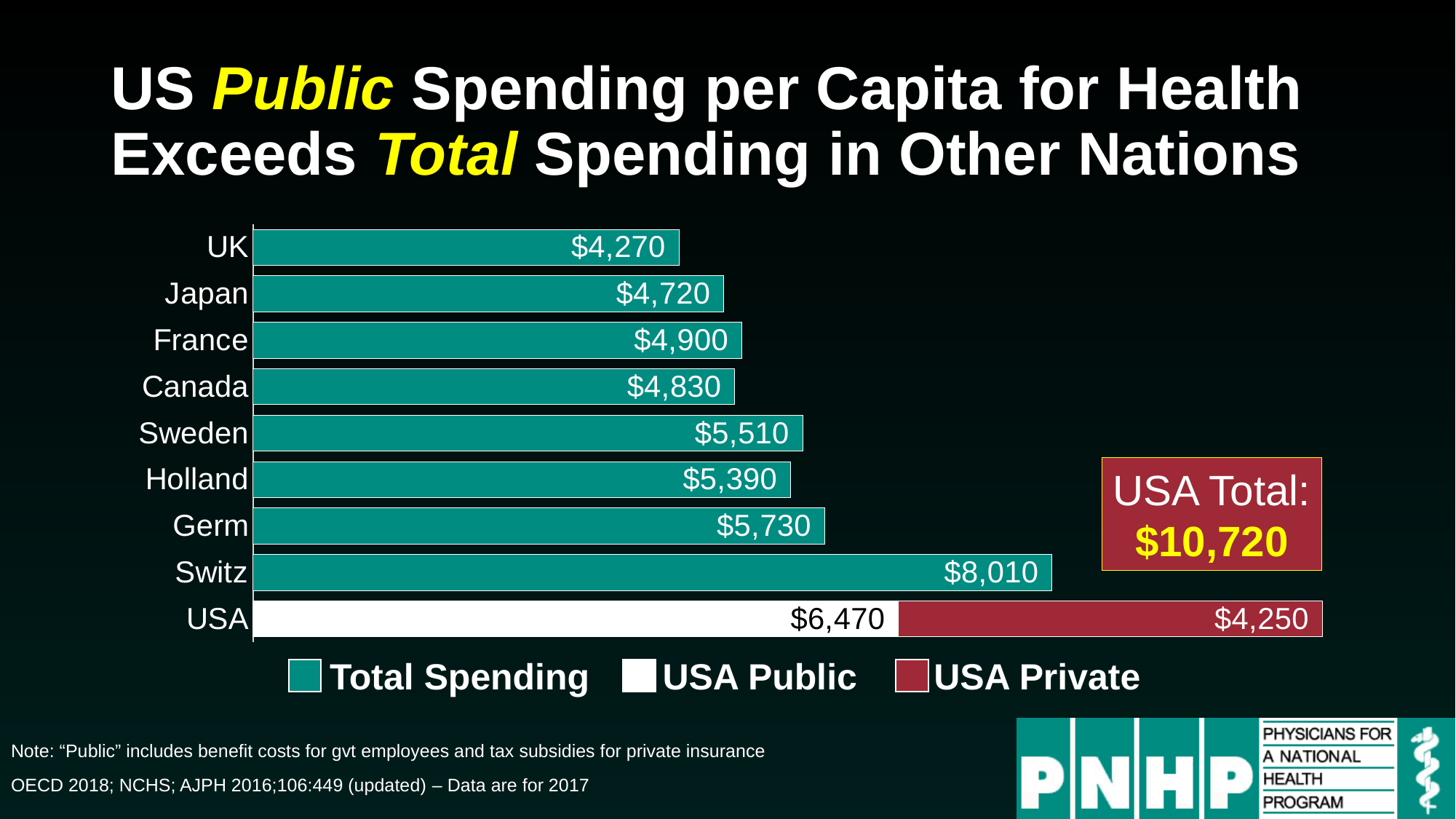
What is the total of the stacked USA bar? $10,720 What is the USA Public spending per capita shown on the chart? $6,470 What kind of chart is shown on the slide? Bar chart How many countries are listed on the chart? 9 What is the USA Private spending per capita shown on the chart? $4,250 Which is larger, total spending for France or for Canada? France Among the non-USA countries, which has the highest total spending per capita? Switz Which country has the lowest total spending per capita on the chart? UK What is the difference between Switzerland's total spending and the USA Public spending? $1,540 What is the total spending per capita for Germany? $5,730 What is the total health spending per capita for Switzerland? $8,010 How many series does the legend list? 3